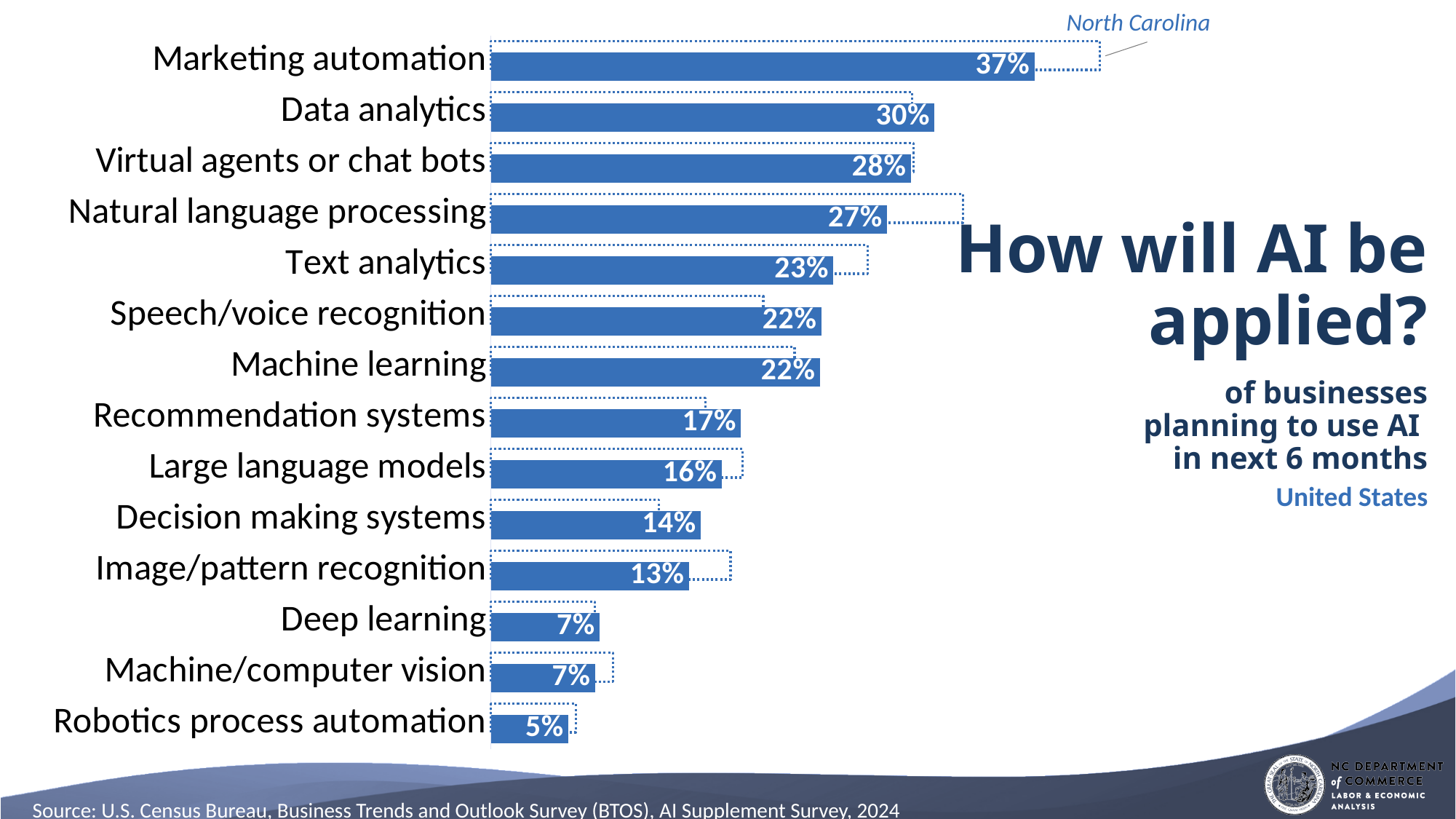
How many AI application categories are shown on the chart? 14 What percentage of United States businesses planning to use AI plan to apply it to Data analytics? 30% Which AI application has the highest United States value on the chart? Marketing automation What is the United States value shown for Large language models? 16% Which has a larger United States value, Text analytics or Decision making systems? Text analytics What is the difference between the United States values for Marketing automation and Data analytics? 7% What is the difference between the United States values for Virtual agents or chat bots and Image/pattern recognition? 15% What do the dotted outlines around the solid bars represent? North Carolina What is the United States value for Marketing automation? 37% What is the United States value shown for Deep learning? 7% What kind of chart is shown on the slide? Bar chart Which AI application has the lowest United States value on the chart? Robotics process automation